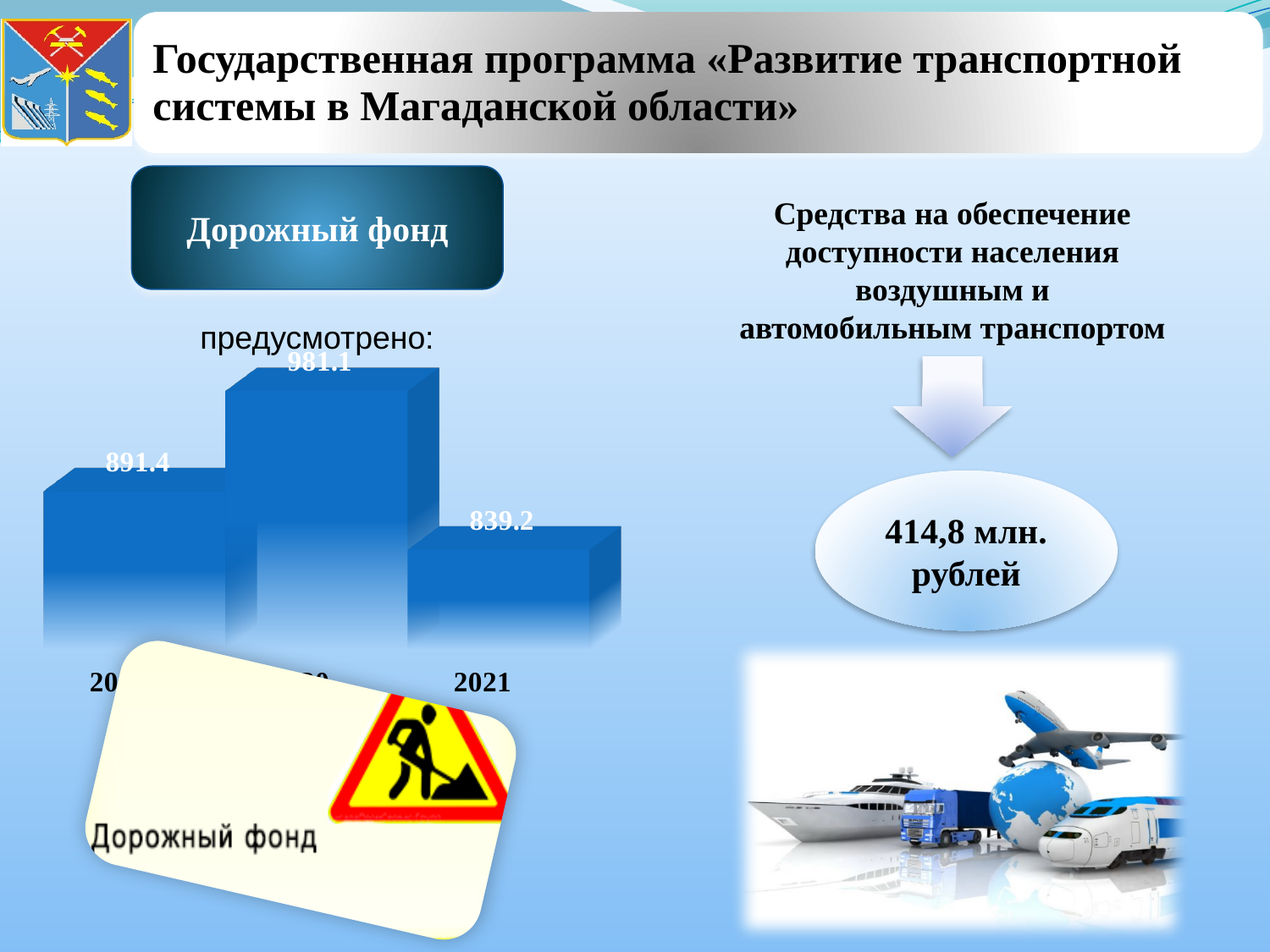
What value is printed on the first (leftmost) bar of the Дорожный фонд chart? 891.4 Which bar in the Дорожный фонд chart is the highest: the first, the middle, or the 2021 bar? the middle bar What value is shown for 2021 in the Дорожный фонд chart? 839.2 What is the difference between the highest bar (981.1) and the 2021 bar in the Дорожный фонд chart? 141.9 Do the values in the Дорожный фонд chart rise or fall from the middle bar to the 2021 bar? fall What type of chart is used for the Дорожный фонд data? bar chart In the Дорожный фонд chart, which is larger: the first bar or the 2021 bar? the first bar What is the difference between the first bar (891.4) and the 2021 bar in the Дорожный фонд chart? 52.2 What value is printed on the tallest bar of the Дорожный фонд chart? 981.1 What word appears directly above the Дорожный фонд bar chart? предусмотрено: How many bars are plotted in the Дорожный фонд chart? 3 Which category has the lowest value in the Дорожный фонд chart? 2021